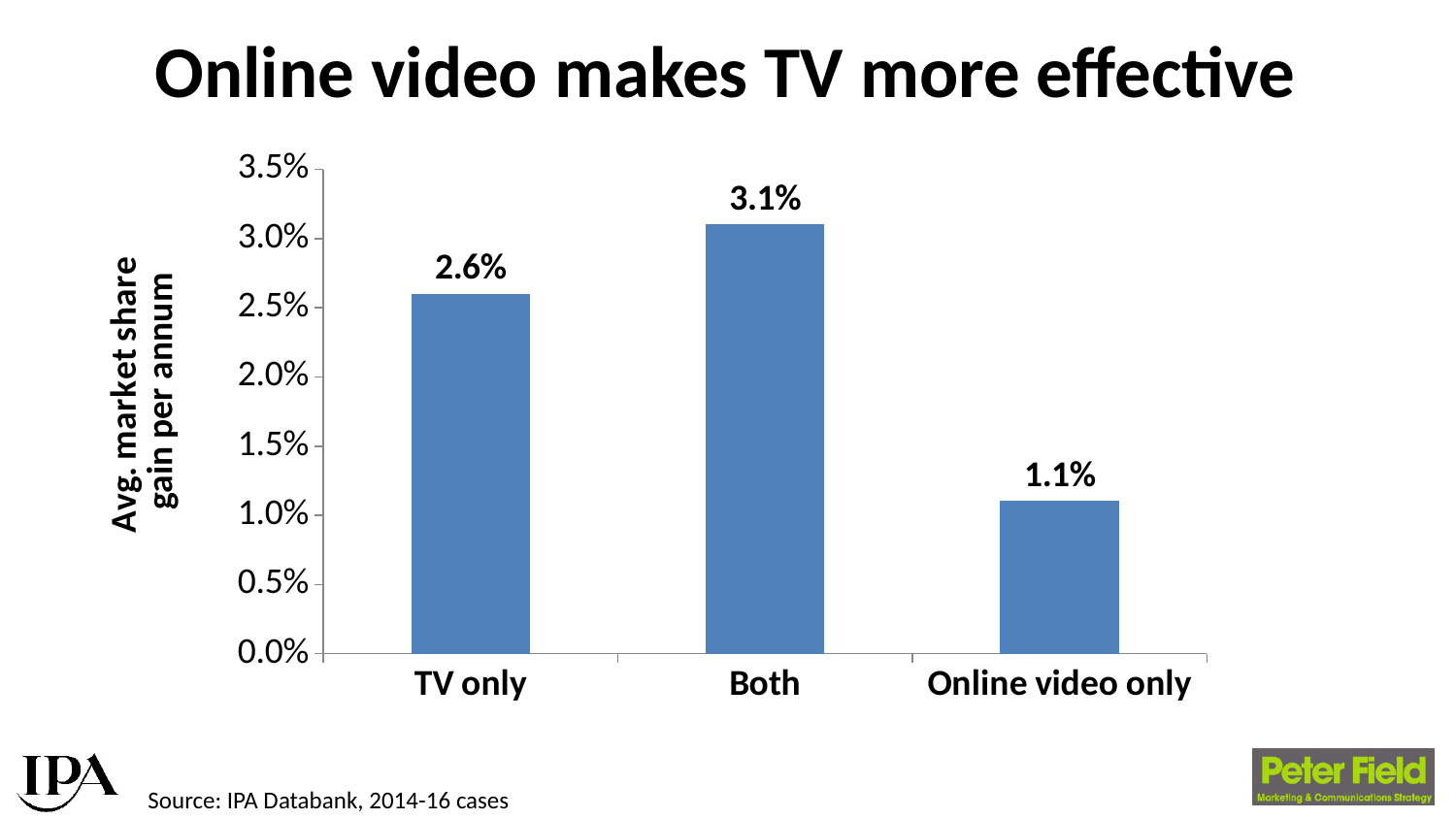
What is the difference in average market share gain per annum between Both and TV only? 0.5% Which category has the lowest average market share gain per annum? Online video only What is the difference in average market share gain per annum between TV only and Online video only? 1.5% What is the average market share gain per annum for Online video only? 1.1% Which category has the highest average market share gain per annum? Both Which has a larger average market share gain per annum, TV only or Online video only? TV only Is the value for Both greater or less than 3.0%? greater What kind of chart is shown on the slide? Bar chart What is the average market share gain per annum for TV only? 2.6% What is the title of the slide? Online video makes TV more effective What is the average market share gain per annum for Both? 3.1% How many categories are shown on the chart? 3